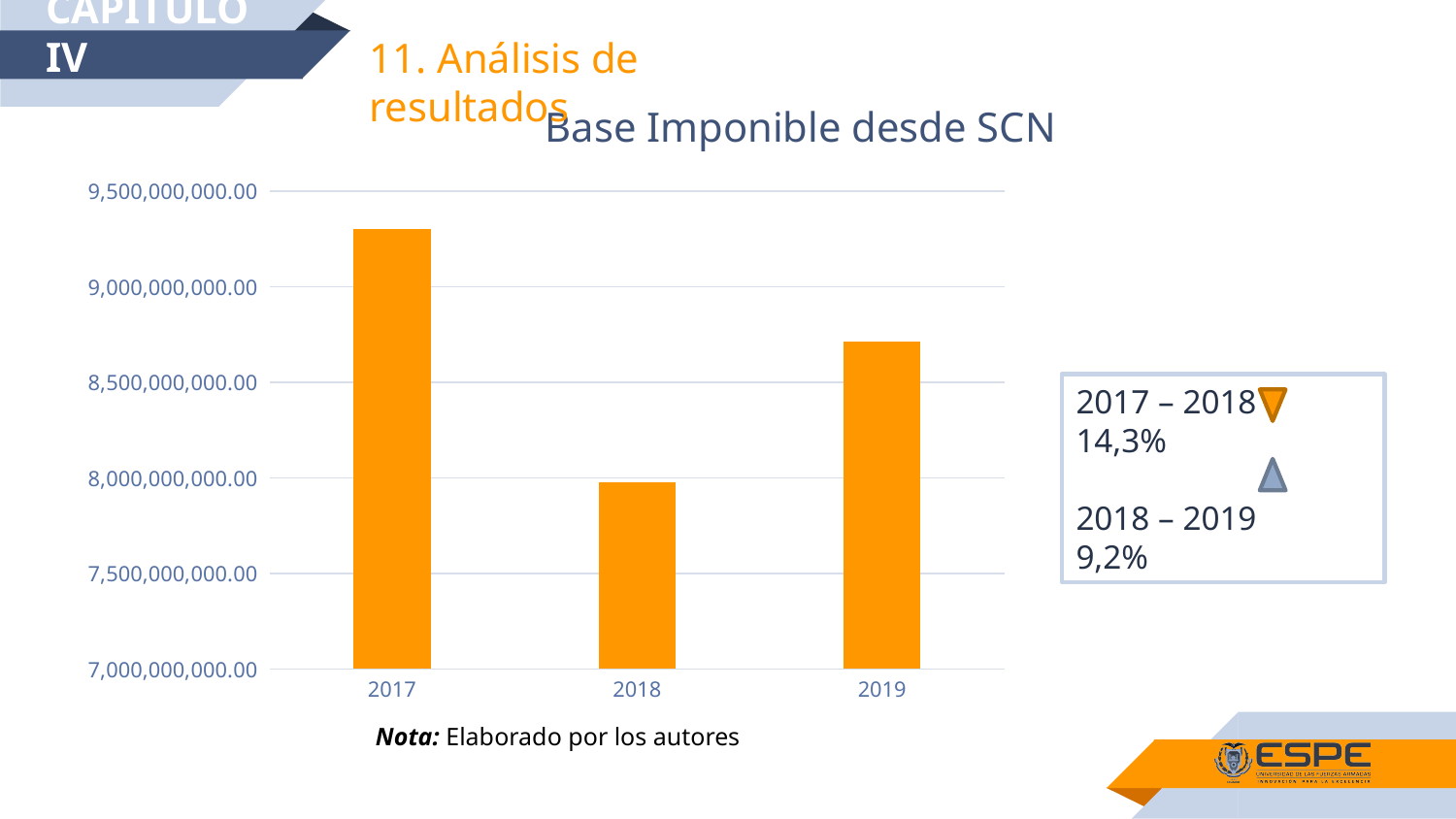
Is the value for 2019 greater or less than 8,500,000,000.00? greater What kind of chart is shown on the slide? Bar chart How many years (categories) are plotted in the chart? 3 Is the value for 2017 greater or less than 9,000,000,000.00? greater Which year has the larger value, 2017 or 2019? 2017 Which year has the lowest Base Imponible value? 2018 Does the value rise or fall from 2017 to 2018? fall Which year has the larger value, 2018 or 2019? 2019 Which year has the highest Base Imponible value? 2017 What is the title of the chart? Base Imponible desde SCN Does the value rise or fall from 2018 to 2019? rise Is the value for 2018 greater or less than 7,500,000,000.00? greater